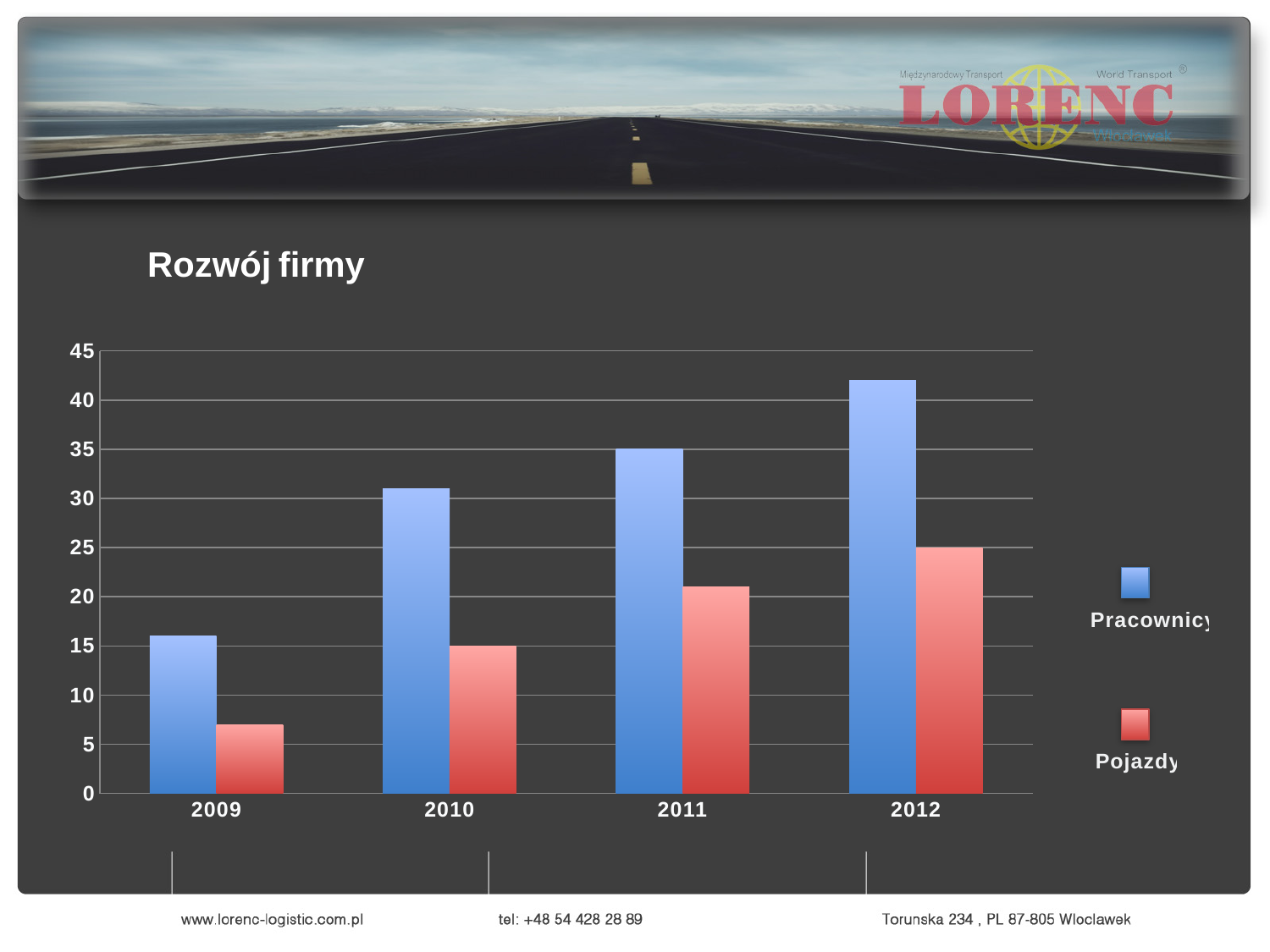
How many years are shown on the x axis? 4 Is the value for Pojazdy in 2009 greater or less than 10? less What kind of chart is shown on the slide? bar chart How many series does the legend list? 2 Which year has the lowest value for Pojazdy? 2009 Which is larger in 2011, Pracownicy or Pojazdy? Pracownicy Which year has the highest value for Pracownicy? 2012 What is the title of the chart? Rozwój firmy Is the value for Pracownicy in 2012 greater or less than 40? greater Do the Pracownicy values rise or fall from 2009 to 2012? rise